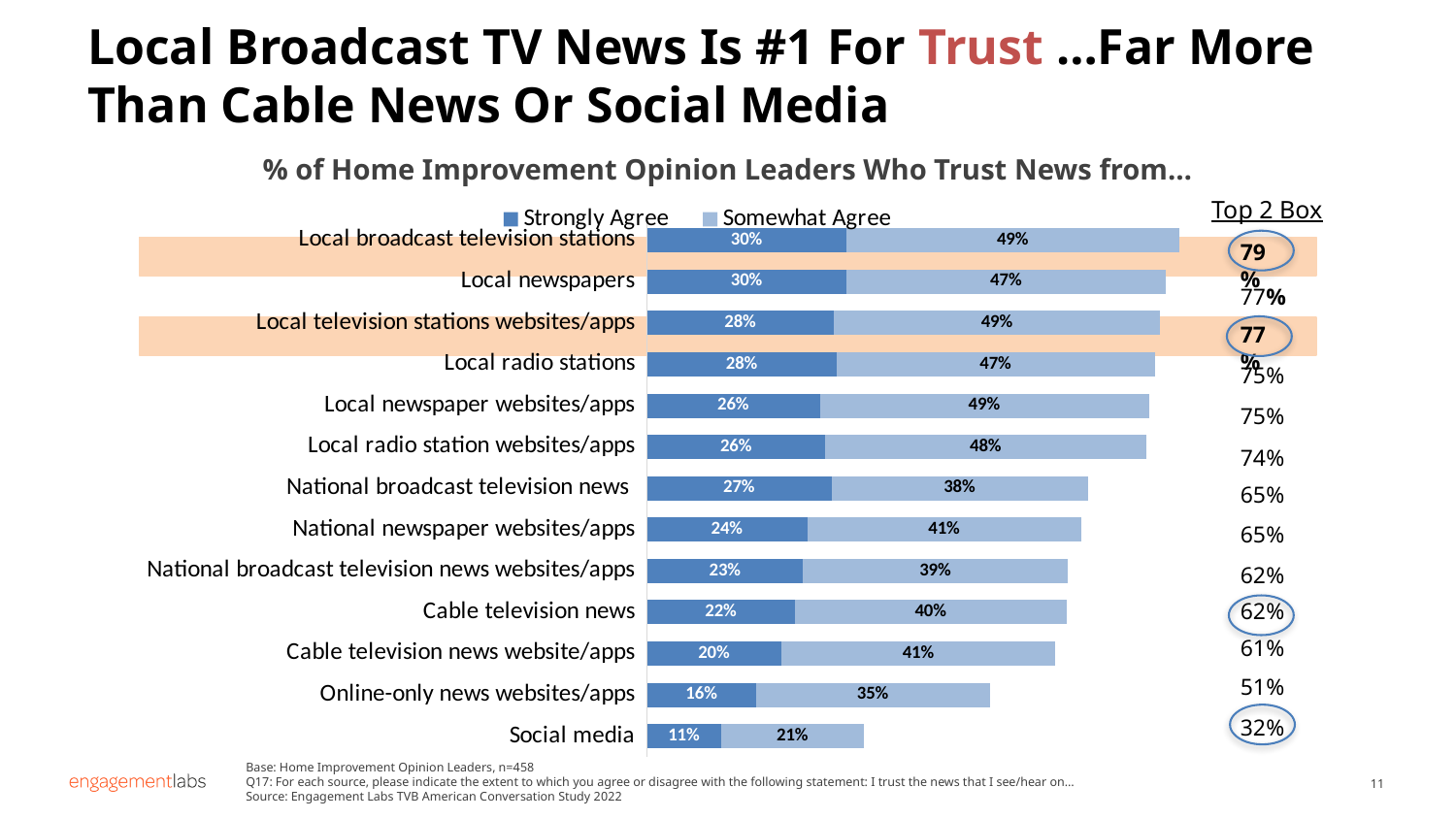
What are the two series named in the legend? Strongly Agree and Somewhat Agree What percentage of Home Improvement Opinion Leaders strongly agree that they trust news from Social media? 11% What is the difference between the Somewhat Agree values for Local broadcast television stations and Social media? 28% What is the total of the stacked bar for Online-only news websites/apps? 51% Which news source has the highest Top 2 Box percentage? Local broadcast television stations What is the Strongly Agree value for National broadcast television news? 27% What is the Somewhat Agree value for Cable television news? 40% Which has a larger Strongly Agree value: Local newspapers or Cable television news? Local newspapers How many series does the legend list? 2 How many news sources are shown in the chart? 13 Which news source has the lowest Strongly Agree percentage? Social media What kind of chart is shown on the slide? Stacked bar chart